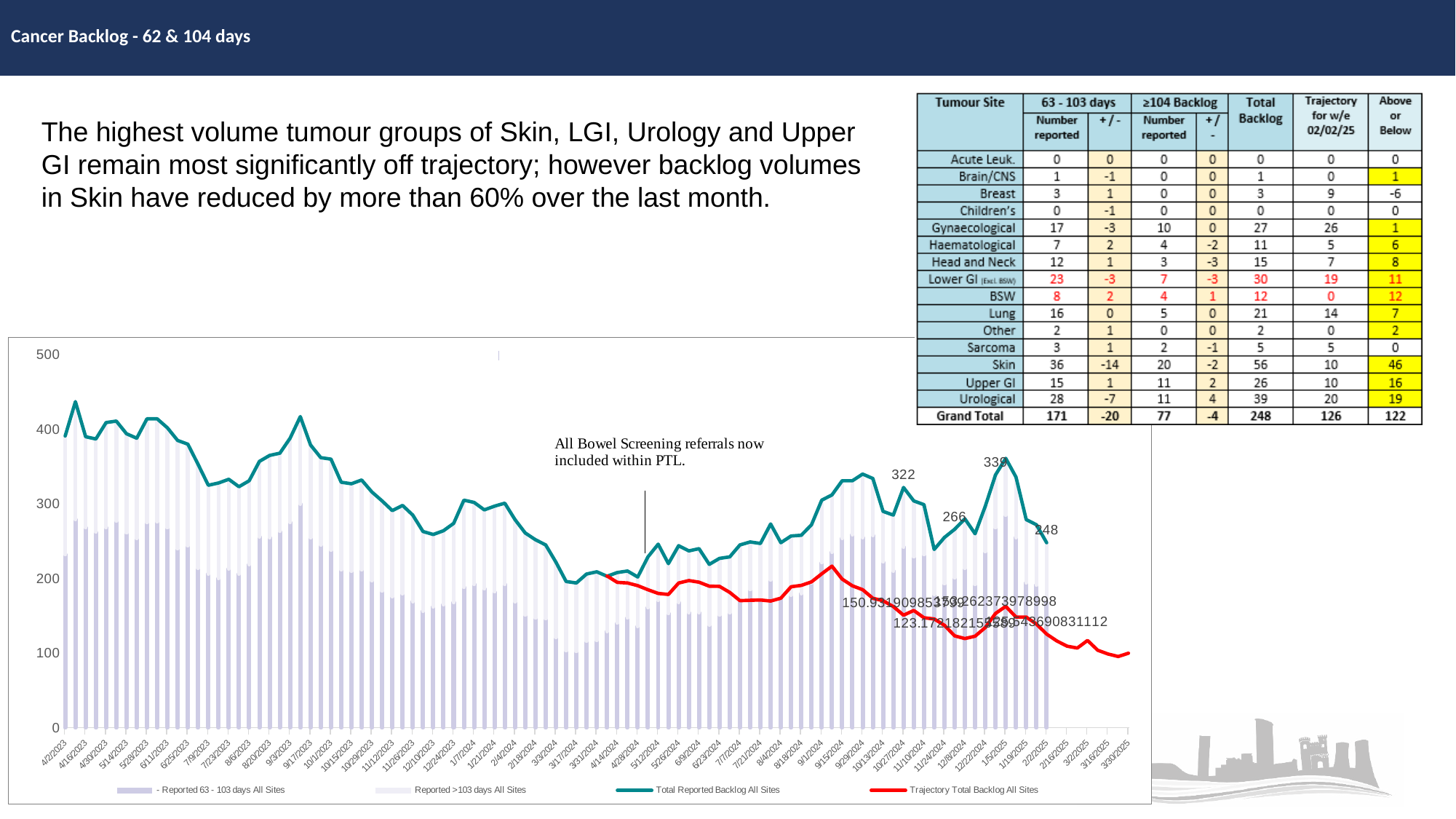
What is the last labelled value on the Total Reported Backlog All Sites line, at 2/2/2025? 248 What is the highest labelled value on the Total Reported Backlog All Sites line? 339 What kind of chart is shown on the slide? Combined bar and line chart What is the difference between the labelled values 339 and 248 on the Total Reported Backlog line? 91 Is the Trajectory Total Backlog All Sites value at 3/30/2025 greater or less than 200? less Which labelled value on the Total Reported Backlog line is larger, 322 or 266? 322 How many series does the chart legend list? 4 What is the difference between the labelled values 322 and 266 on the Total Reported Backlog line? 56 Is the Total Reported Backlog All Sites value at 3/17/2024 greater or less than 300? less Is the Total Reported Backlog All Sites value at 4/2/2023 greater or less than 300? greater What colour is the Trajectory Total Backlog All Sites line in the chart? Red Does the Trajectory Total Backlog All Sites line rise or fall overall from 4/14/2024 to 3/30/2025? fall